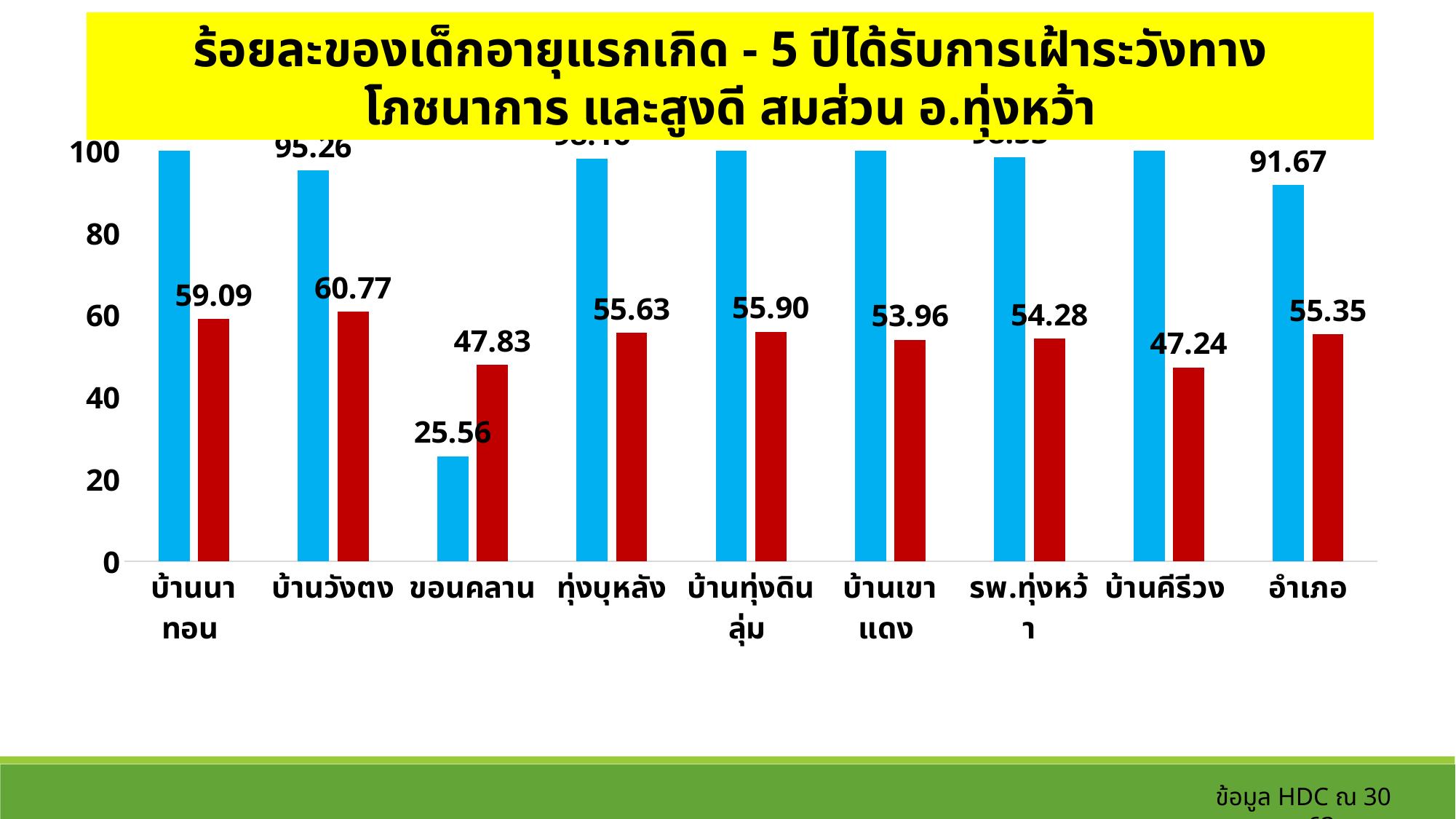
What is the value of the red bar for บ้านคีรีวง? 47.24 Which is larger: the red bar for บ้านทุ่งดินลุ่ม or the red bar for บ้านเขาแดง? บ้านทุ่งดินลุ่ม What is the value of the blue bar for ขอนคลาน? 25.56 Is the value of the blue bar for บ้านนาทอน greater or less than 80? greater Which category has the lowest blue bar? ขอนคลาน What is the value of the blue bar for อำเภอ? 91.67 What is the value of the red bar for บ้านนาทอน? 59.09 What type of chart is shown on the slide? bar chart How many categories are shown along the x axis of the chart? 9 Which category has the highest red bar? บ้านวังตง What is the difference between the red bar values for บ้านนาทอน and ขอนคลาน? 11.26